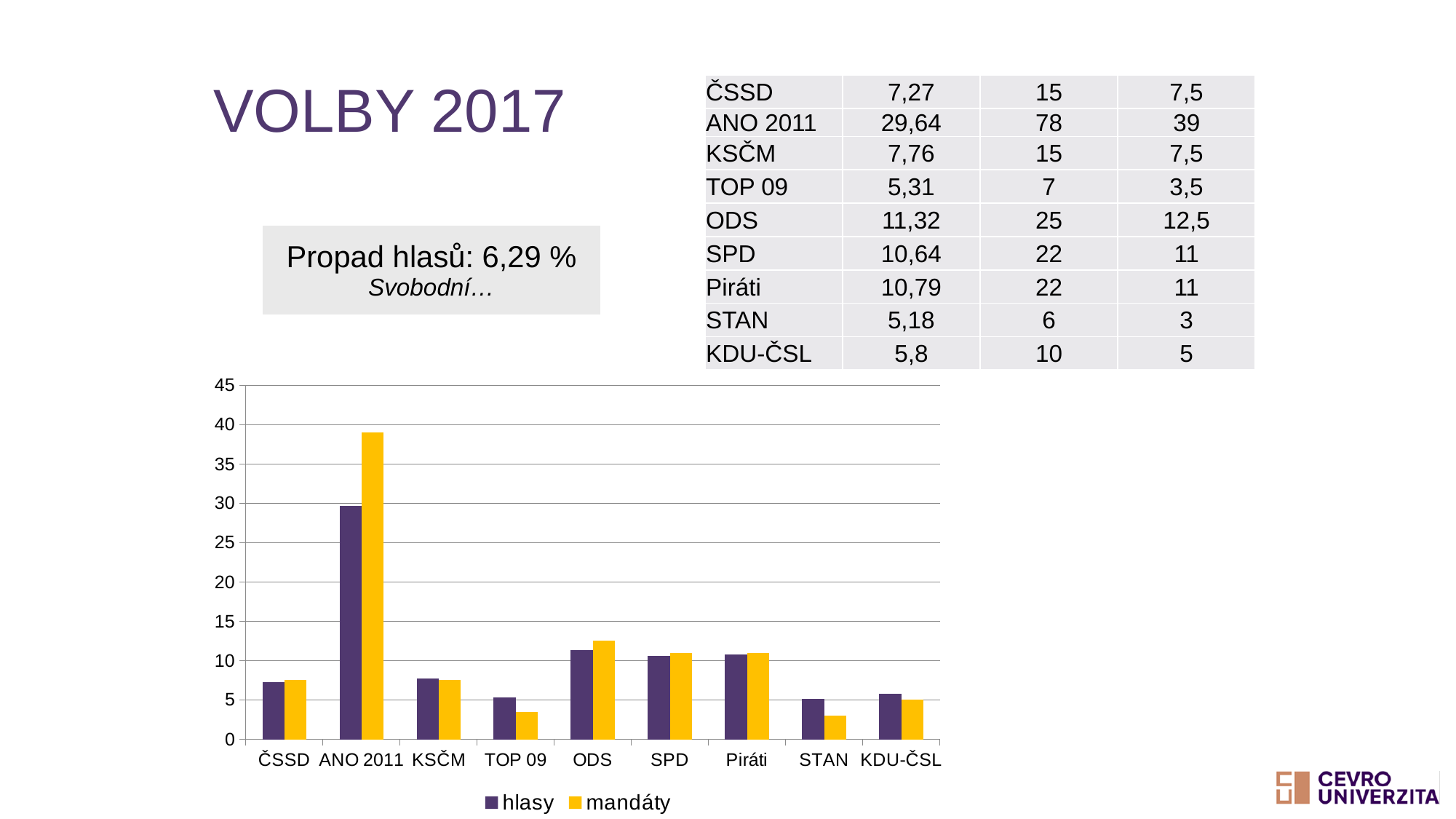
How many parties are shown on the x axis of the chart? 9 What are the two series named in the chart legend? hlasy and mandáty Which is larger for STAN: the hlasy bar or the mandáty bar? hlasy Which party has the lowest mandáty bar in the chart? STAN What is the mandáty value for ODS in the chart? 12,5 What kind of chart is shown on the slide? bar chart Is the hlasy value for TOP 09 greater or less than 10? less What is the hlasy value for ANO 2011 in the chart? 29,64 Which party has the highest hlasy bar in the chart? ANO 2011 What is the difference between the mandáty value for ANO 2011 and the mandáty value for ODS? 26,5 Is the mandáty value for ANO 2011 greater or less than 35? greater How many series does the chart legend list? 2